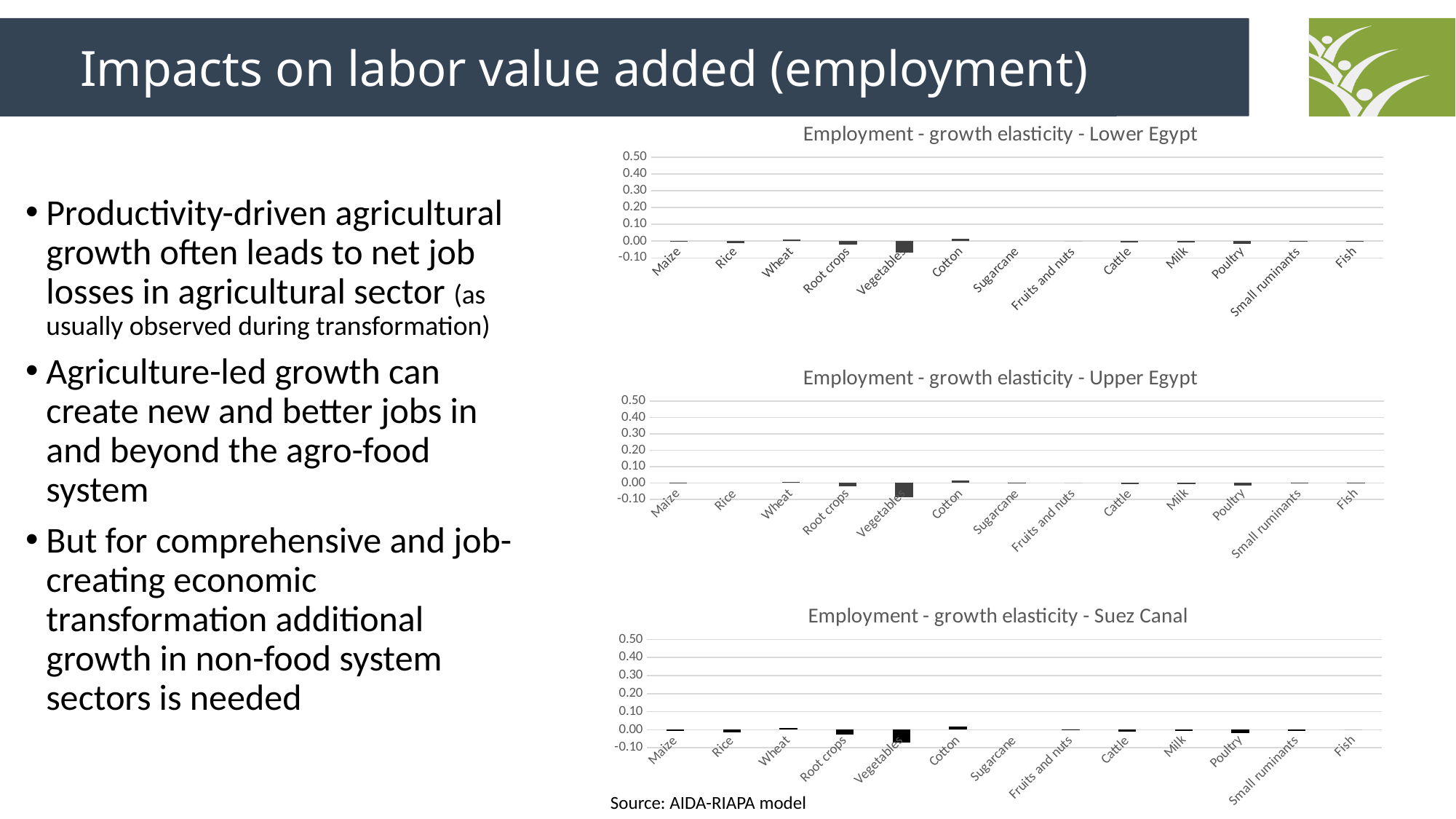
In the "Employment - growth elasticity - Suez Canal" chart, is the value for Maize greater or less than 0.10? less In the "Employment - growth elasticity - Lower Egypt" chart, which category has the lowest value? Vegetables In the "Employment - growth elasticity - Suez Canal" chart, which is larger, the value for Cotton or the value for Vegetables? Cotton What is the highest value shown on the y axis of the "Employment - growth elasticity - Lower Egypt" chart? 0.50 In the "Employment - growth elasticity - Lower Egypt" chart, is the value for Vegetables greater or less than 0.00? less What kind of chart is the "Employment - growth elasticity - Lower Egypt" chart? Bar chart In the "Employment - growth elasticity - Upper Egypt" chart, which category has the lowest value? Vegetables What is the title of the bottom chart on the slide? Employment - growth elasticity - Suez Canal How many charts are shown on the slide? 3 How many categories are shown on the x axis of the "Employment - growth elasticity - Upper Egypt" chart? 13 In the "Employment - growth elasticity - Suez Canal" chart, which category has the lowest value? Vegetables In the "Employment - growth elasticity - Upper Egypt" chart, is the value for Cotton greater or less than 0.00? greater